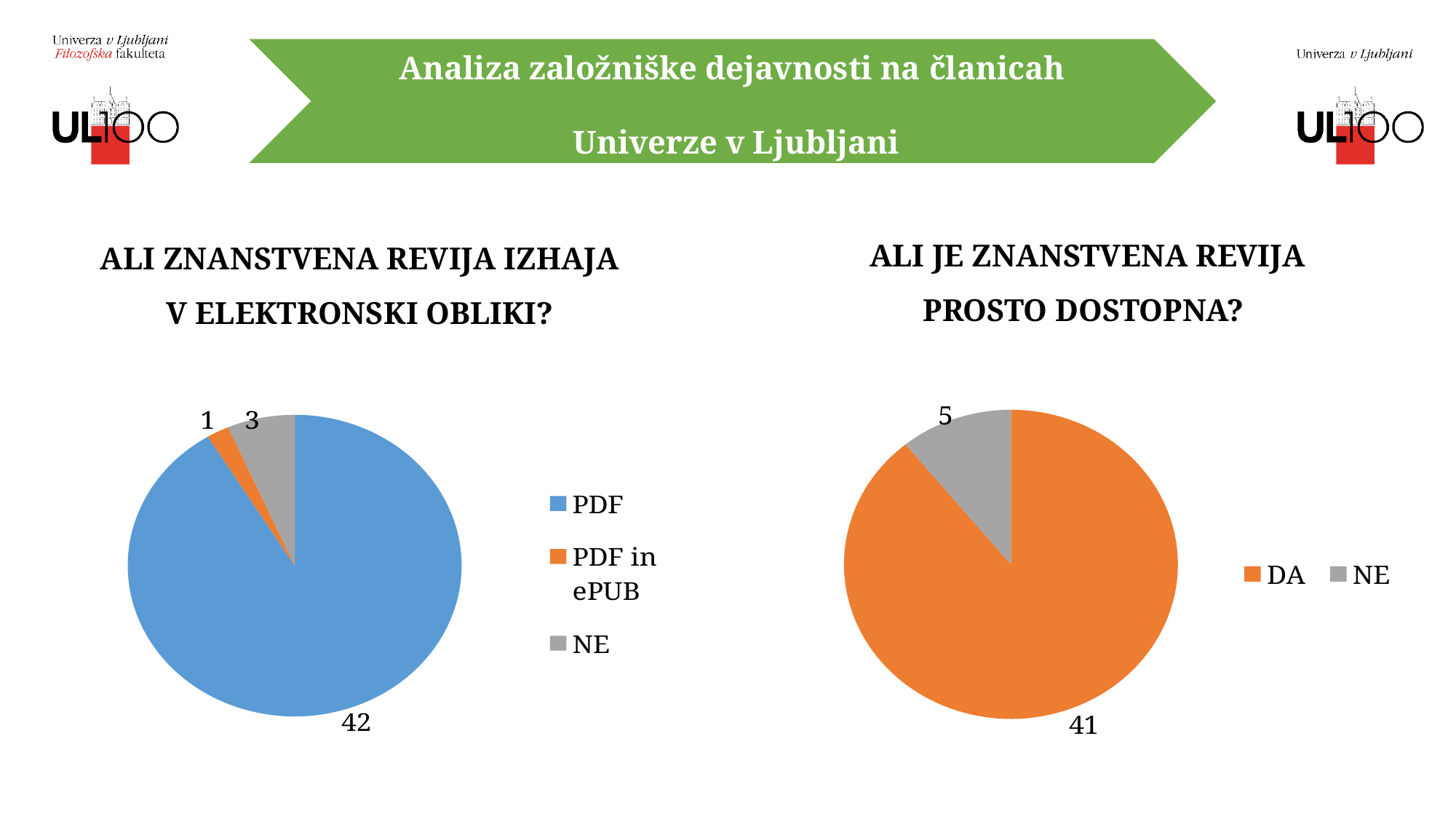
In the right chart (ALI JE ZNANSTVENA REVIJA PROSTO DOSTOPNA?), what is the difference between DA and NE? 36 In the right chart (ALI JE ZNANSTVENA REVIJA PROSTO DOSTOPNA?), what colour is the DA slice? Orange In the left chart (ALI ZNANSTVENA REVIJA IZHAJA V ELEKTRONSKI OBLIKI?), what is the value for PDF in ePUB? 1 What type of chart is the right chart (ALI JE ZNANSTVENA REVIJA PROSTO DOSTOPNA?)? Pie chart In the left chart (ALI ZNANSTVENA REVIJA IZHAJA V ELEKTRONSKI OBLIKI?), what is the value for PDF? 42 In the left chart (ALI ZNANSTVENA REVIJA IZHAJA V ELEKTRONSKI OBLIKI?), which category has the smallest slice? PDF in ePUB In the left chart (ALI ZNANSTVENA REVIJA IZHAJA V ELEKTRONSKI OBLIKI?), what is the value for NE? 3 In the right chart (ALI JE ZNANSTVENA REVIJA PROSTO DOSTOPNA?), what is the value for NE? 5 In the right chart (ALI JE ZNANSTVENA REVIJA PROSTO DOSTOPNA?), which category has the largest slice? DA How many categories does the left chart (ALI ZNANSTVENA REVIJA IZHAJA V ELEKTRONSKI OBLIKI?) show? 3 In the left chart (ALI ZNANSTVENA REVIJA IZHAJA V ELEKTRONSKI OBLIKI?), which is larger, NE or PDF in ePUB? NE In the right chart (ALI JE ZNANSTVENA REVIJA PROSTO DOSTOPNA?), what is the value for DA? 41